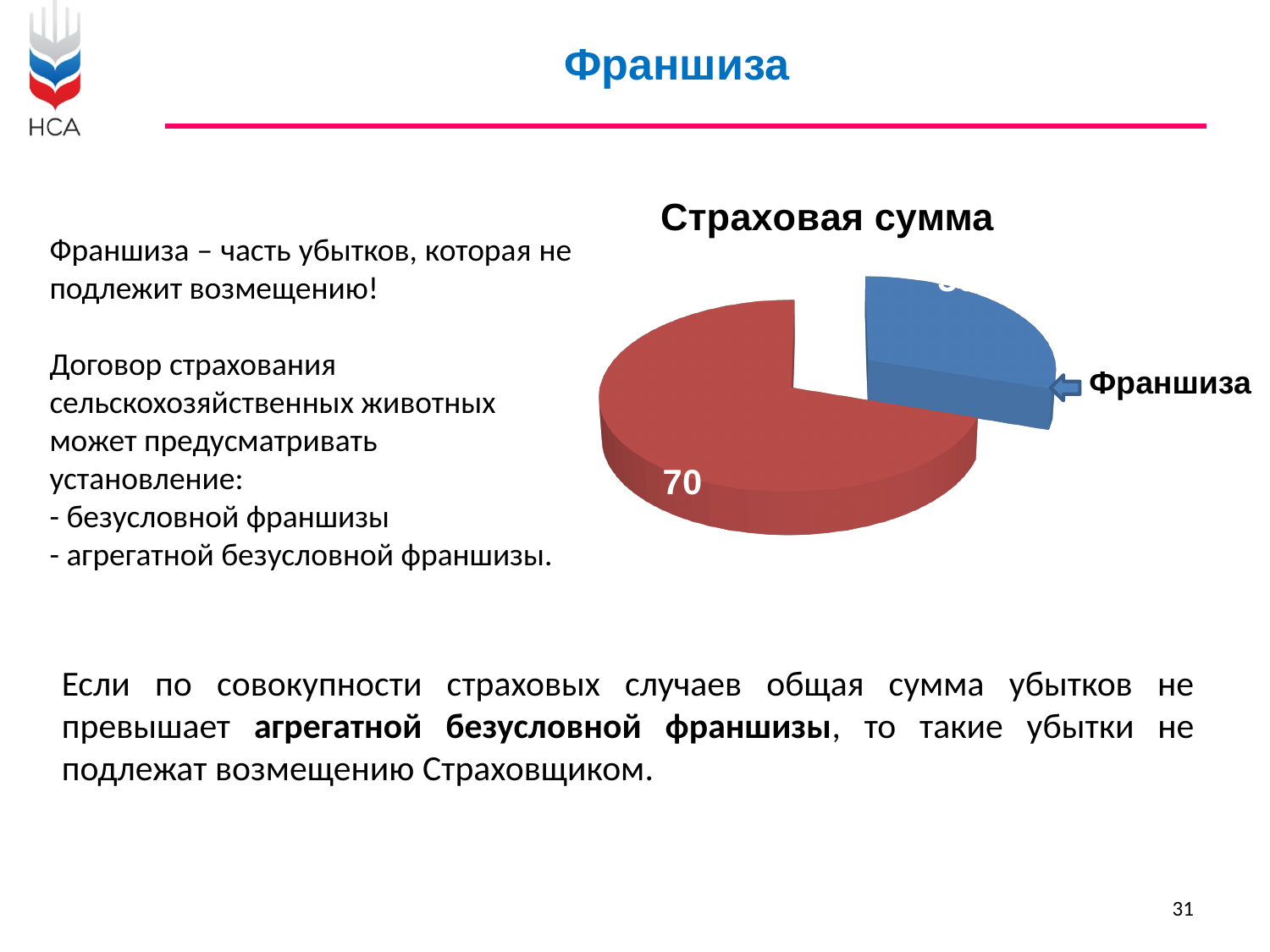
Which slice of the pie chart is the smallest? The blue slice (Франшиза) Which slice of the pie chart is the largest? The red slice (70) Is the slice labelled Франшиза larger or smaller than the slice labelled 70? Smaller Which is larger: the red slice or the blue slice labelled Франшиза? The red slice How many slices does the pie chart have? 2 What label does the arrow next to the blue slice point to? Франшиза What is the title of the chart? Страховая сумма What value is printed on the red slice of the pie chart? 70 What kind of chart is shown on the slide? Pie chart